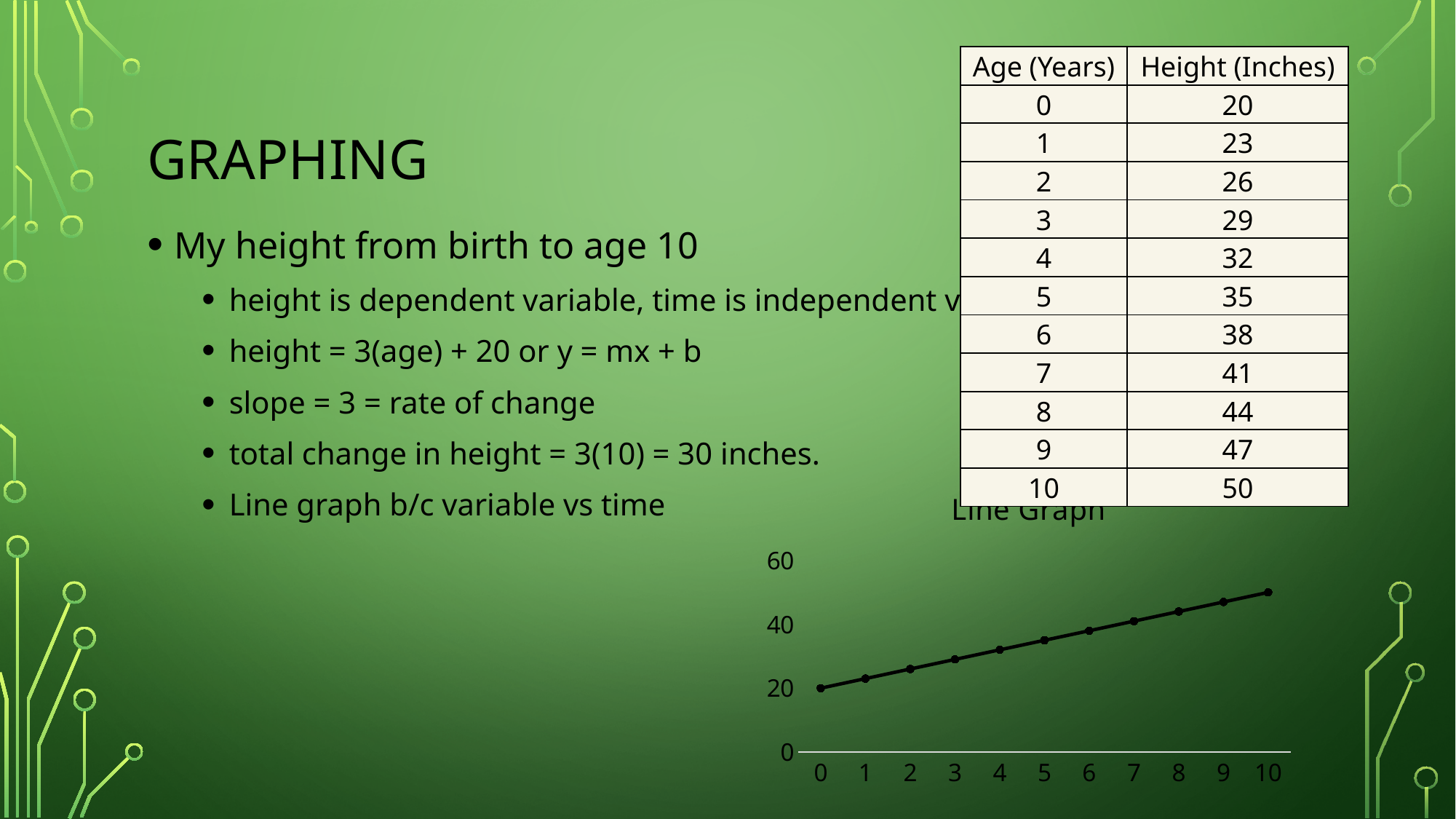
At which age is the plotted height highest? 10 At which age is the plotted height lowest? 0 Do the values on the line chart rise or fall as age increases along the x axis? rise How many data points are plotted on the line chart? 11 Is the value plotted at age 3 greater or less than 20? greater According to the table on the slide, what is the height in inches at age 10? 50 Is the value plotted at age 4 greater or less than 40? less What is the title of the chart? Line Graph What is the height value plotted at age 0? 20 Which is larger on the line chart, the value at age 8 or the value at age 2? age 8 What kind of chart is shown on the slide? line chart Is the value plotted at age 10 greater or less than 40? greater